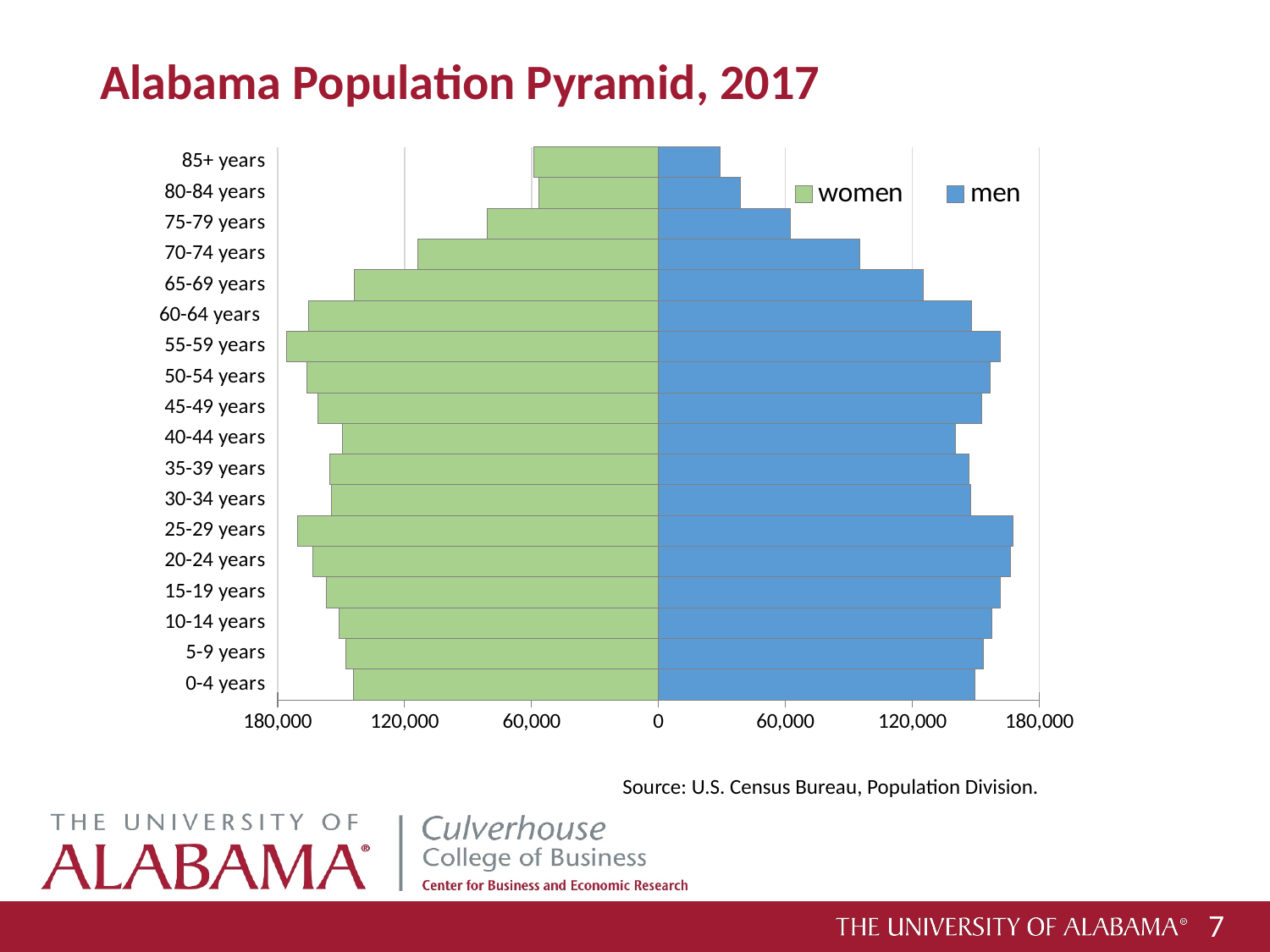
Is the number of men aged 25-29 years greater or less than 120,000? greater Which is larger: the number of men aged 70-74 years or the number of men aged 75-79 years? 70-74 years What is the title of the chart on the slide? Alabama Population Pyramid, 2017 How many series does the legend list? 2 What kind of chart is shown on the slide? bar chart Which colour represents women in the chart? green How many age groups are shown on the chart? 18 Is the number of men aged 85+ years greater or less than 60,000? less Is the number of women aged 75-79 years greater or less than 60,000? greater Which age group has the smallest number of men? 85+ years Which is larger: the number of women aged 25-29 years or the number of women aged 30-34 years? 25-29 years Which age group has the largest number of women? 55-59 years